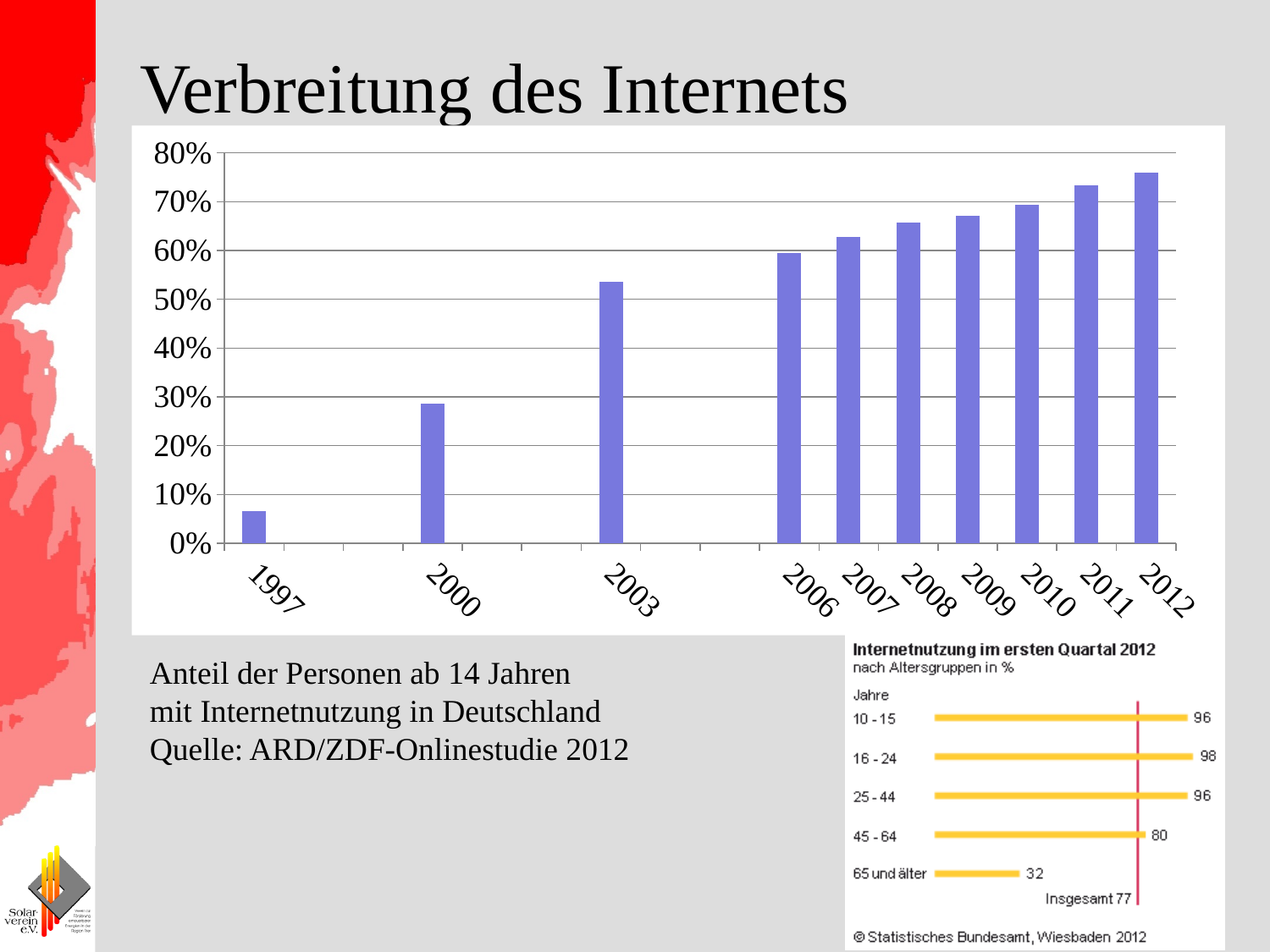
On the large bar chart at the top of the slide, how many years have bars plotted? 10 In the chart 'Internetnutzung im ersten Quartal 2012', how many age groups are shown as bars? 5 On the large bar chart at the top of the slide, which year has the highest bar? 2012 In the chart 'Internetnutzung im ersten Quartal 2012', what is the value for the age group 45 - 64? 80 On the large bar chart at the top of the slide, do the values rise or fall from 1997 to 2012? rise What kind of chart is the large chart at the top of the slide? bar chart On the large bar chart at the top of the slide, is the value for 2000 greater or less than 30%? less On the large bar chart at the top of the slide, which year has the lowest bar? 1997 In the chart 'Internetnutzung im ersten Quartal 2012', which age group has the lowest value? 65 und älter On the large bar chart at the top of the slide, is the value for 2012 greater or less than 70%? greater In the chart 'Internetnutzung im ersten Quartal 2012', what is the difference between the values for 16 - 24 and 65 und älter? 66 On the large bar chart at the top of the slide, is the value for 2003 greater or less than 50%? greater